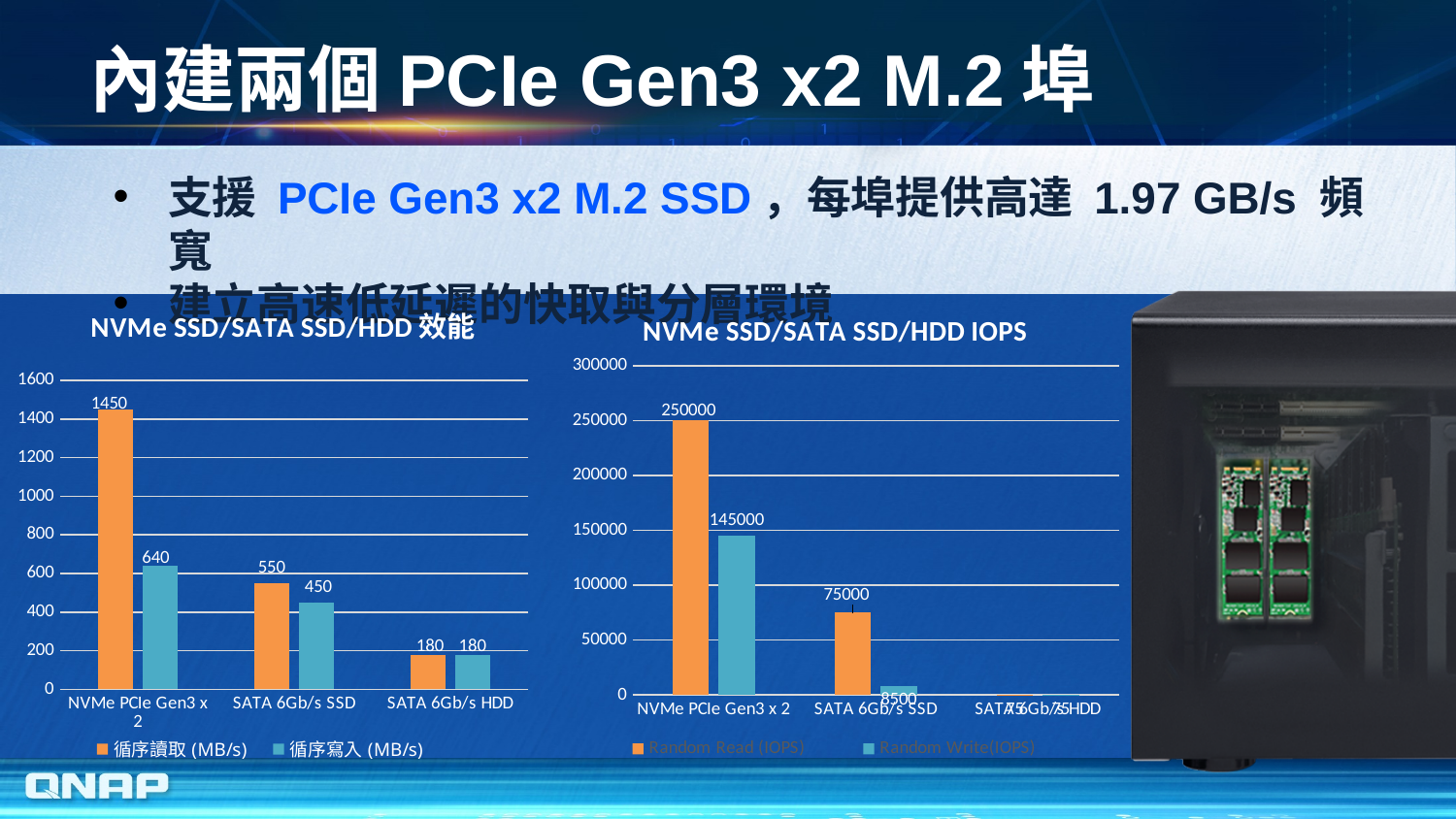
How many series does the legend of the NVMe SSD/SATA SSD/HDD 效能 chart list? 2 In the NVMe SSD/SATA SSD/HDD IOPS chart, what is the Random Write(IOPS) value for SATA 6Gb/s SSD? 8500 In the NVMe SSD/SATA SSD/HDD IOPS chart, what is the Random Read (IOPS) value for NVMe PCIe Gen3 x 2? 250000 What type of chart is the NVMe SSD/SATA SSD/HDD IOPS chart? Bar chart In the NVMe SSD/SATA SSD/HDD 效能 chart, which category has the highest 循序讀取 (MB/s) value? NVMe PCIe Gen3 x 2 In the NVMe SSD/SATA SSD/HDD IOPS chart, which is larger for NVMe PCIe Gen3 x 2: Random Read (IOPS) or Random Write(IOPS)? Random Read (IOPS) In the NVMe SSD/SATA SSD/HDD 效能 chart, what is the difference between the 循序讀取 and 循序寫入 values for NVMe PCIe Gen3 x 2? 810 In the NVMe SSD/SATA SSD/HDD 效能 chart, how many categories are shown on the x axis? 3 In the NVMe SSD/SATA SSD/HDD 效能 chart, what is the 循序寫入 (MB/s) value for SATA 6Gb/s HDD? 180 In the NVMe SSD/SATA SSD/HDD 效能 chart, what is the 循序讀取 (MB/s) value for NVMe PCIe Gen3 x 2? 1450 In the NVMe SSD/SATA SSD/HDD IOPS chart, what is the difference between the Random Read values for NVMe PCIe Gen3 x 2 and SATA 6Gb/s SSD? 175000 In the NVMe SSD/SATA SSD/HDD 效能 chart, what is the 循序寫入 (MB/s) value for SATA 6Gb/s SSD? 450